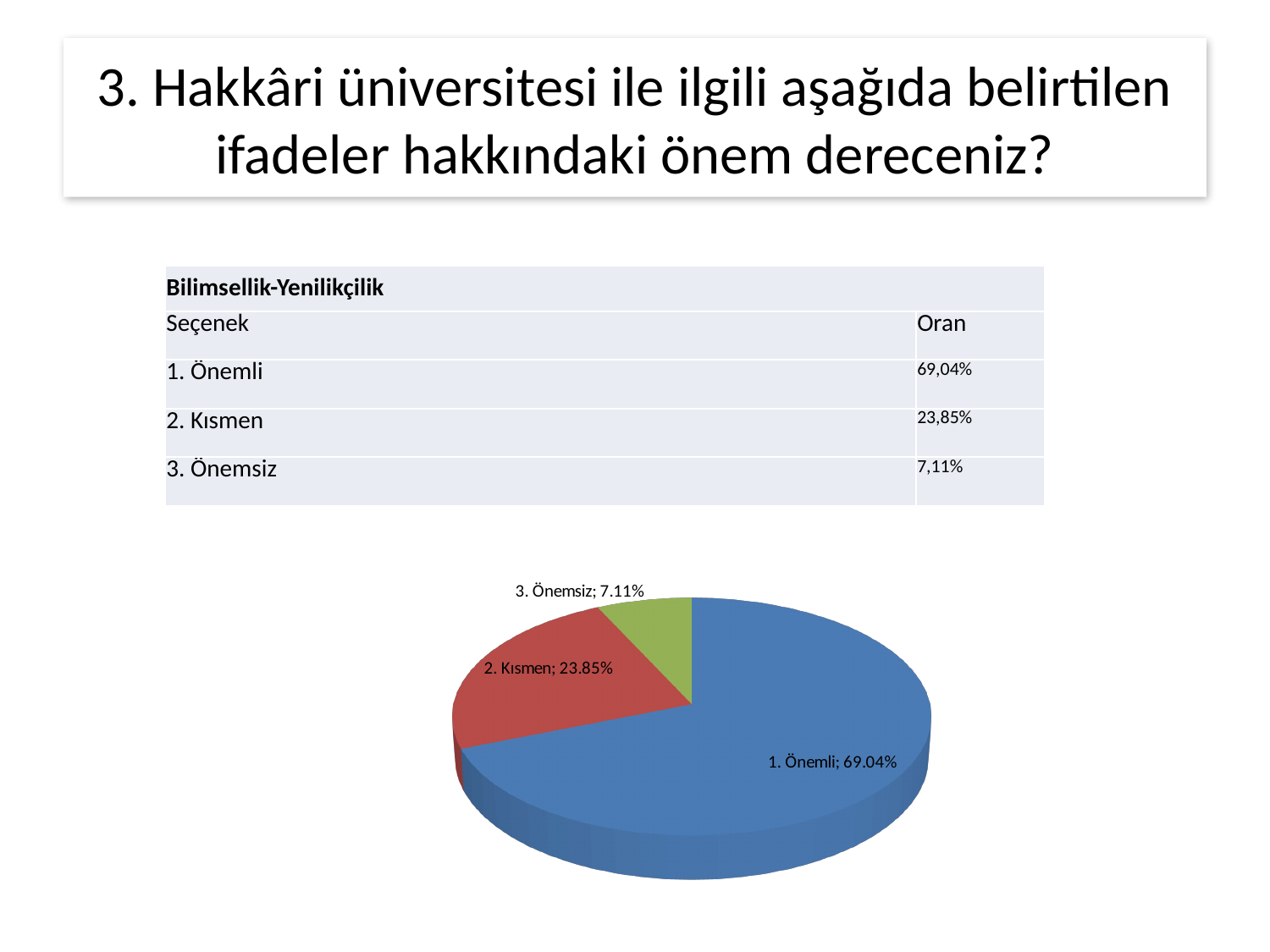
What is the value for 3. Önemsiz in the pie chart? 7.11% What is the value for 2. Kısmen in the pie chart? 23.85% What kind of chart is shown on the slide? pie chart Which category has the largest slice in the pie chart? 1. Önemli What colour is the slice for 3. Önemsiz in the pie chart? green How many slices does the pie chart have? 3 What is the difference between the values for 2. Kısmen and 3. Önemsiz in the pie chart? 16.74% Which is larger in the pie chart, 2. Kısmen or 3. Önemsiz? 2. Kısmen What is the difference between the values for 1. Önemli and 2. Kısmen in the pie chart? 45.19% Which category has the smallest slice in the pie chart? 3. Önemsiz What is the value for 1. Önemli in the pie chart? 69.04% What colour is the slice for 1. Önemli in the pie chart? blue